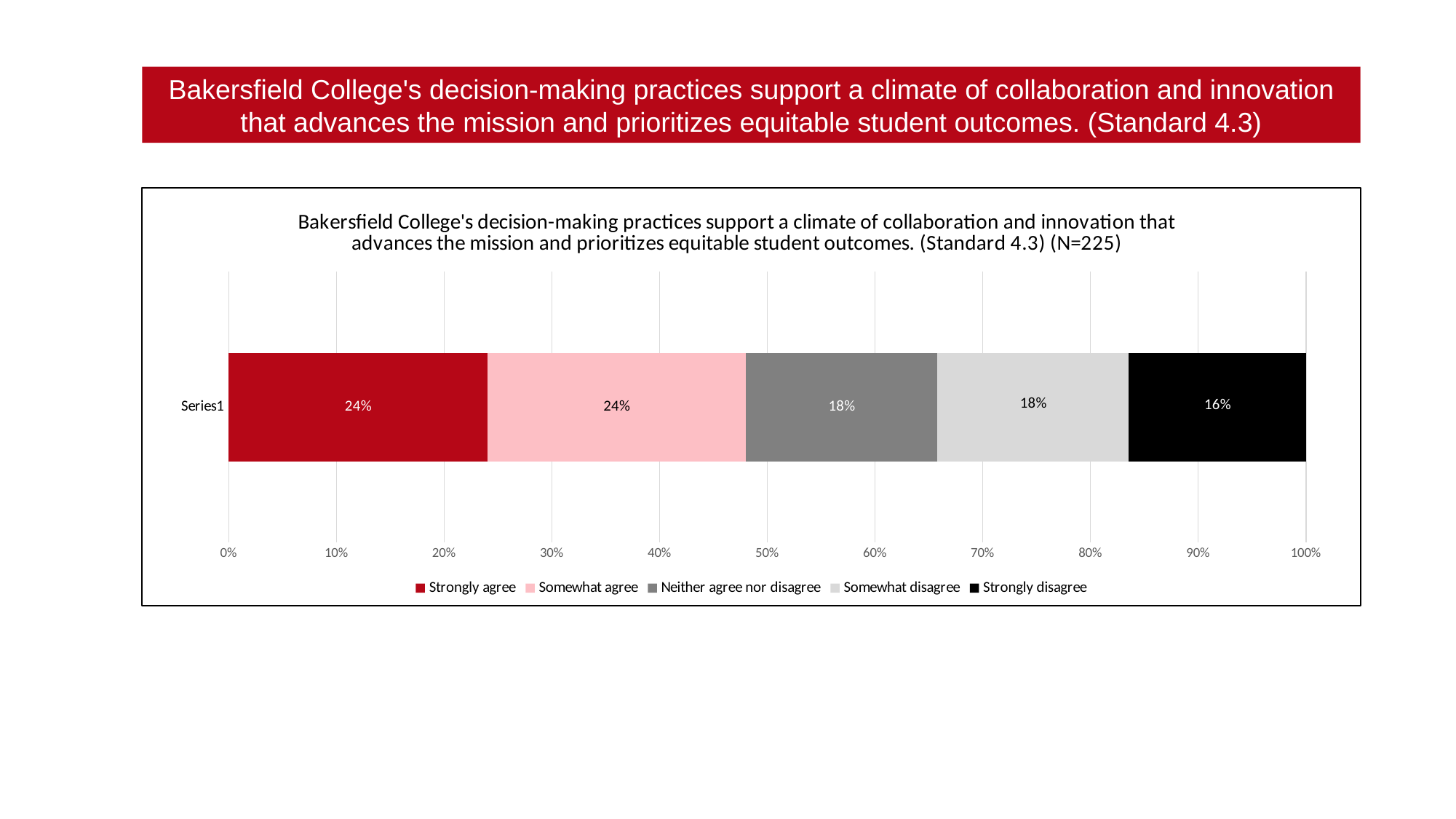
What percentage of respondents selected "Strongly disagree"? 16% What colour represents "Strongly disagree" in the chart? Black How many series does the legend list? 5 What is the combined share of "Strongly agree" and "Somewhat agree"? 48% What percentage of respondents selected "Neither agree nor disagree"? 18% What is the sample size (N) stated in the chart title? 225 Which is larger, the share for "Somewhat agree" or the share for "Somewhat disagree"? Somewhat agree Which response category has the smallest share? Strongly disagree What kind of chart is shown on the slide? Stacked bar chart What is the difference between the "Strongly agree" share and the "Strongly disagree" share? 8% What percentage of respondents selected "Strongly agree"? 24% What percentage of respondents selected "Somewhat disagree"? 18%